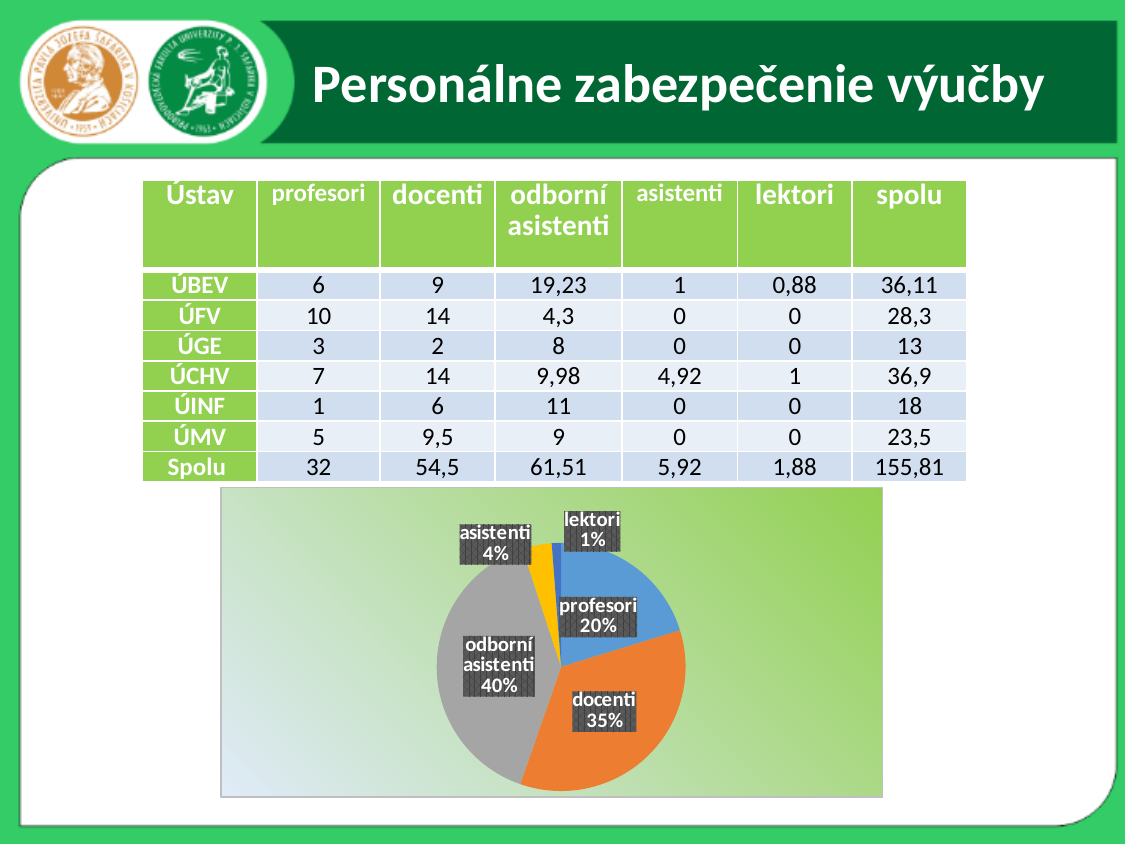
What colour is the docenti slice in the pie chart? orange What share of the pie chart does the slice for asistenti represent? 4% Which category has the largest slice in the pie chart? odborní asistenti In the pie chart, which slice is larger: asistenti or lektori? asistenti What share of the pie chart does the slice for odborní asistenti represent? 40% In the pie chart, what is the difference in percentage points between the docenti slice and the profesori slice? 15 percentage points What share of the pie chart does the slice for profesori represent? 20% What kind of chart is shown on the slide? pie chart How many slices does the pie chart have? 5 Which category has the smallest slice in the pie chart? lektori